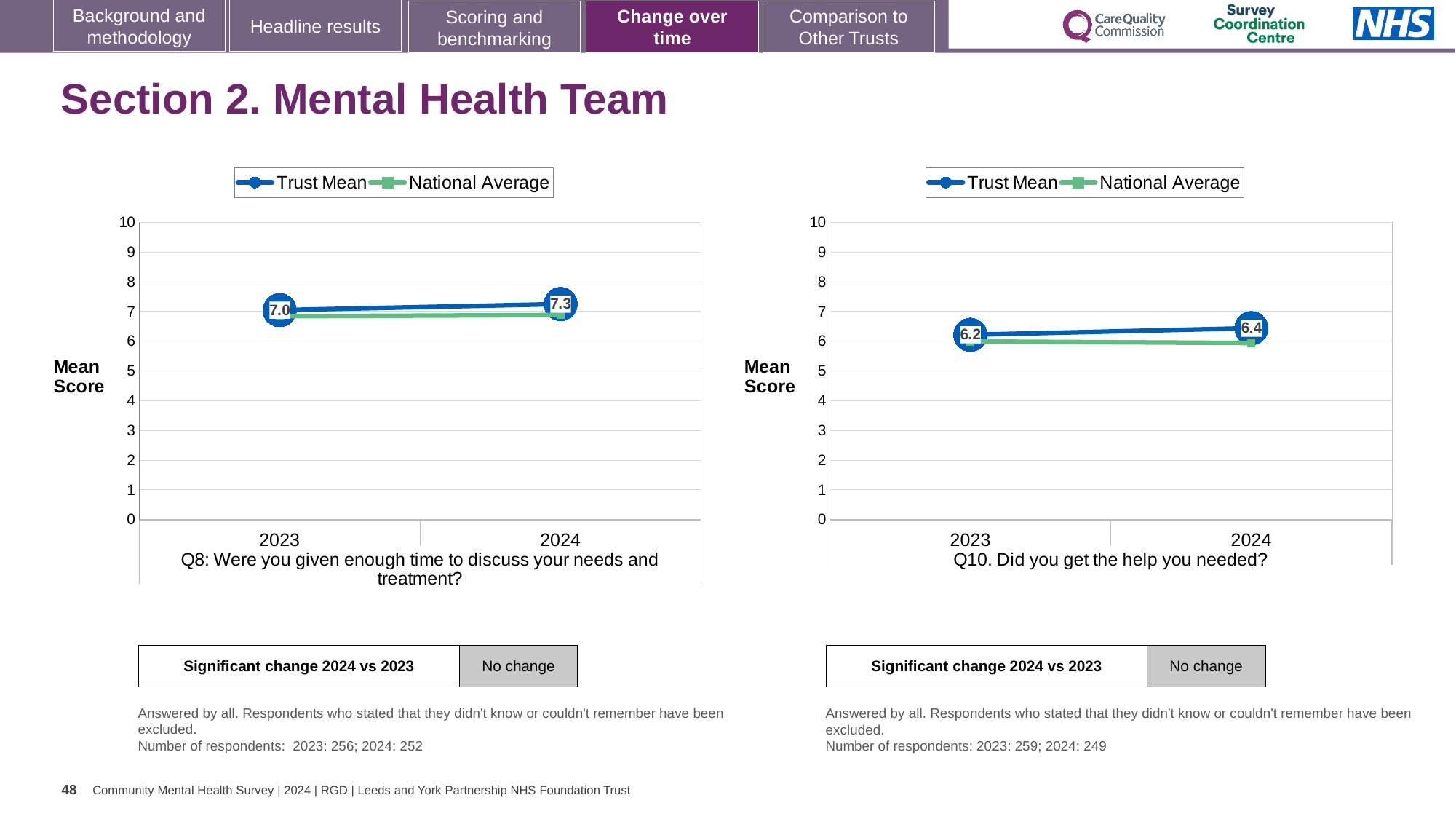
In the Q10 chart on the right, is the National Average for 2024 greater or less than 7? less What kind of chart is the Q10 chart on the right? line chart In the Q8 chart on the left, does the Trust Mean rise or fall from 2023 to 2024? rise In the Q10 chart on the right, what is the Trust Mean for 2023? 6.2 In the Q10 chart on the right, is the Trust Mean for 2024 greater or less than 6? greater In the Q8 chart on the left, what is the Trust Mean for 2024? 7.3 In the Q8 chart on the left, what is the Trust Mean for 2023? 7.0 In the Q10 chart on the right, what is the difference between the Trust Mean in 2024 and in 2023? 0.2 In the Q8 chart on the left, by how much did the Trust Mean change from 2023 to 2024? 0.3 In the Q10 chart on the right, what is the Trust Mean for 2024? 6.4 How many series does the legend of the Q8 chart on the left list? 2 In the Q10 chart on the right, which series is higher in 2024, Trust Mean or National Average? Trust Mean